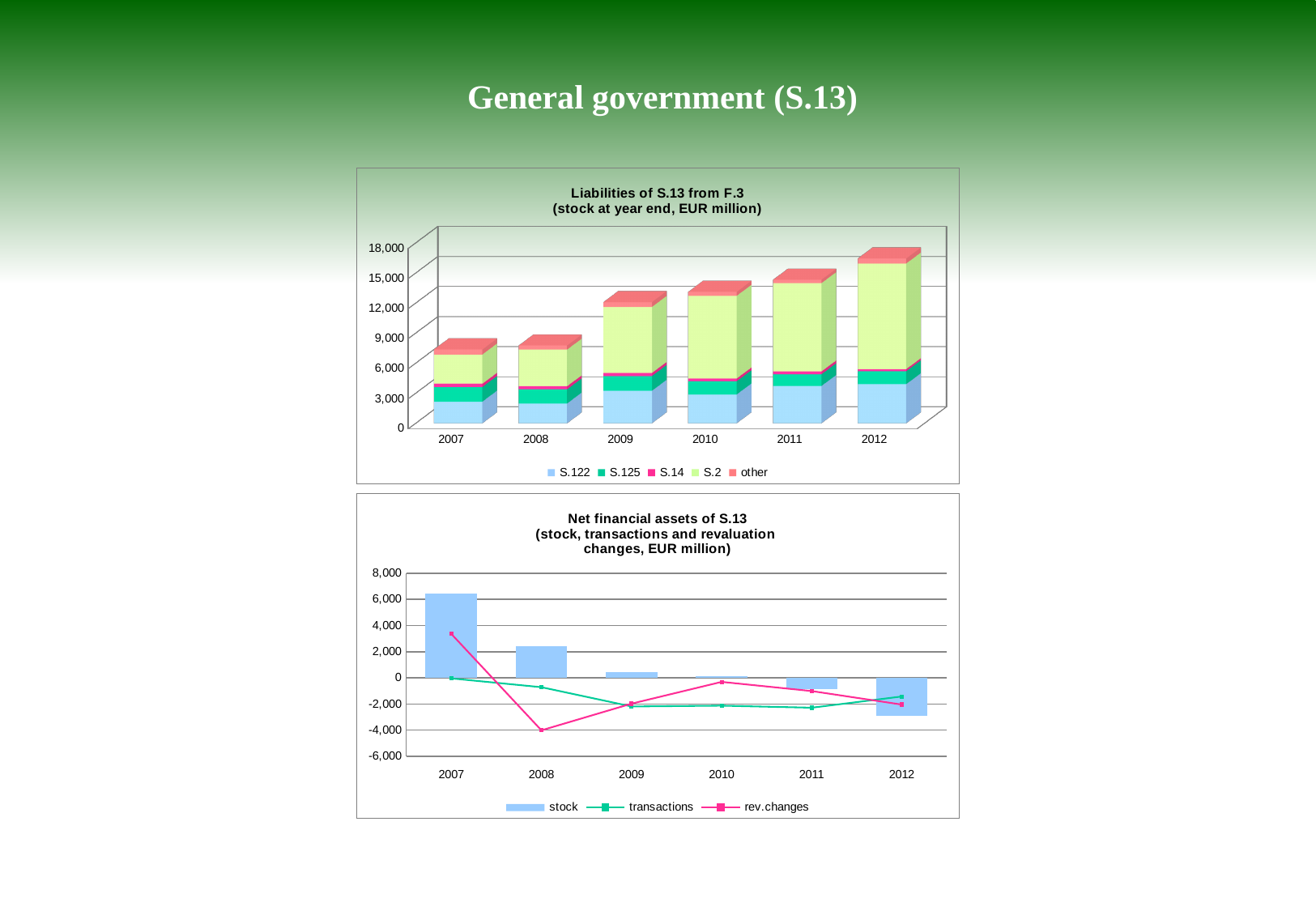
In the top chart 'Liabilities of S.13 from F.3', is the total bar for 2012 greater or less than 15,000? greater In the bottom chart 'Net financial assets of S.13', in which year is the rev.changes value lowest? 2008 In the top chart 'Liabilities of S.13 from F.3', which year has the highest total stacked bar? 2012 In the top chart 'Liabilities of S.13 from F.3', which year has the lowest total stacked bar? 2007 In the bottom chart 'Net financial assets of S.13', is the rev.changes value for 2007 greater or less than 2,000? greater What kind of chart is the top chart, 'Liabilities of S.13 from F.3'? stacked bar chart In the top chart 'Liabilities of S.13 from F.3', is the total bar for 2007 greater or less than 9,000? less In the bottom chart 'Net financial assets of S.13', which series is drawn as bars? stock How many series does the legend of the top chart 'Liabilities of S.13 from F.3' list? 5 In the top chart 'Liabilities of S.13 from F.3', do the total liabilities rise or fall from 2007 to 2012? rise How many years are shown on the x axis of the top chart 'Liabilities of S.13 from F.3'? 6 In the bottom chart 'Net financial assets of S.13', which year has the highest stock value? 2007